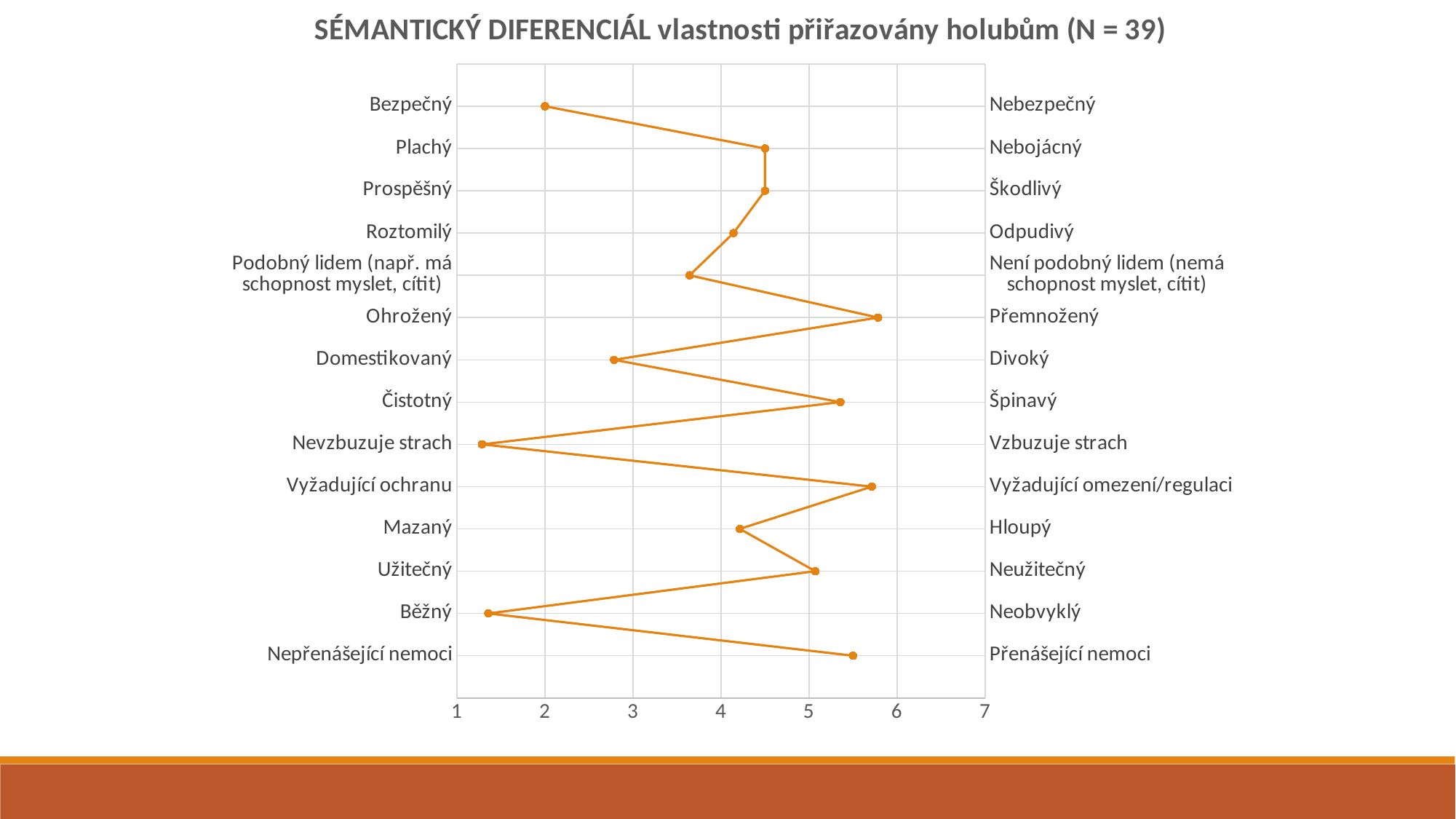
Is the value for the Bezpečný – Nebezpečný pair greater or less than 3? less Is the value for the Nepřenášející nemoci – Přenášející nemoci pair greater or less than 5? greater Is the value for the Nevzbuzuje strach – Vzbuzuje strach pair greater or less than 2? less How many attribute pairs (categories) are plotted on the chart? 14 What is the title of the chart? SÉMANTICKÝ DIFERENCIÁL vlastnosti přiřazovány holubům (N = 39) Which has the larger value: the Ohrožený – Přemnožený pair or the Domestikovaný – Divoký pair? Ohrožený – Přemnožený What kind of chart is shown on the slide? line chart Which has the larger value: the Čistotný – Špinavý pair or the Roztomilý – Odpudivý pair? Čistotný – Špinavý What is the sample size (N) stated in the chart title? 39